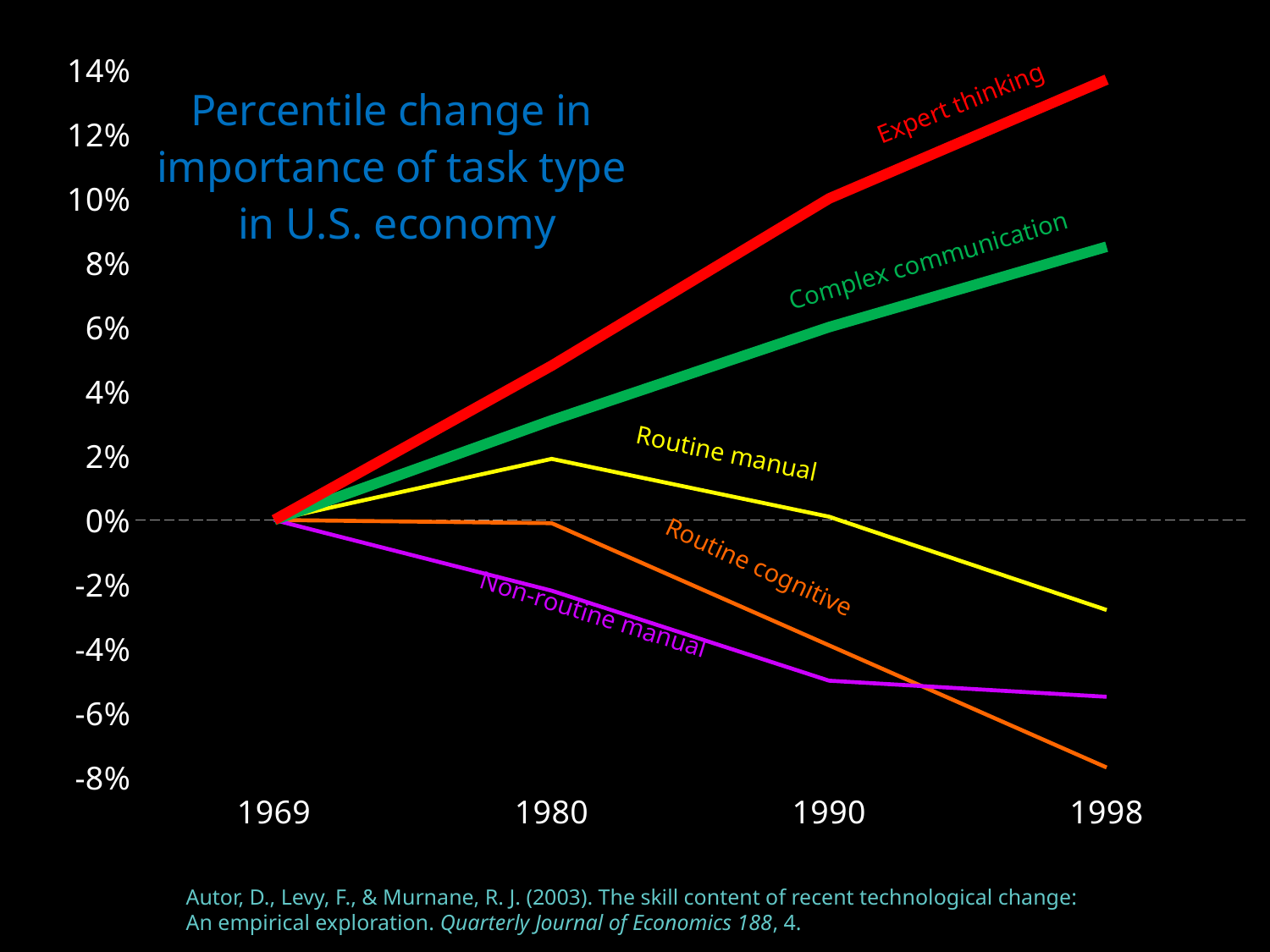
Which task type has the lowest value in 1998? Routine cognitive Is the value for Expert thinking in 1998 greater or less than 12%? greater What is the value for Complex communication in 1969? 0% Which task type has the highest value in 1998? Expert thinking Is the value for Routine cognitive in 1998 greater or less than -6%? less How many years are marked on the x axis? 4 How many task-type series are plotted on the chart? 5 What is the title of the chart? Percentile change in importance of task type in U.S. economy Is the value for Non-routine manual in 1998 greater or less than -4%? less Does the Routine cognitive line rise or fall from 1980 to 1998? fall In 1998, which is larger: Expert thinking or Complex communication? Expert thinking What kind of chart is shown on the slide? line chart